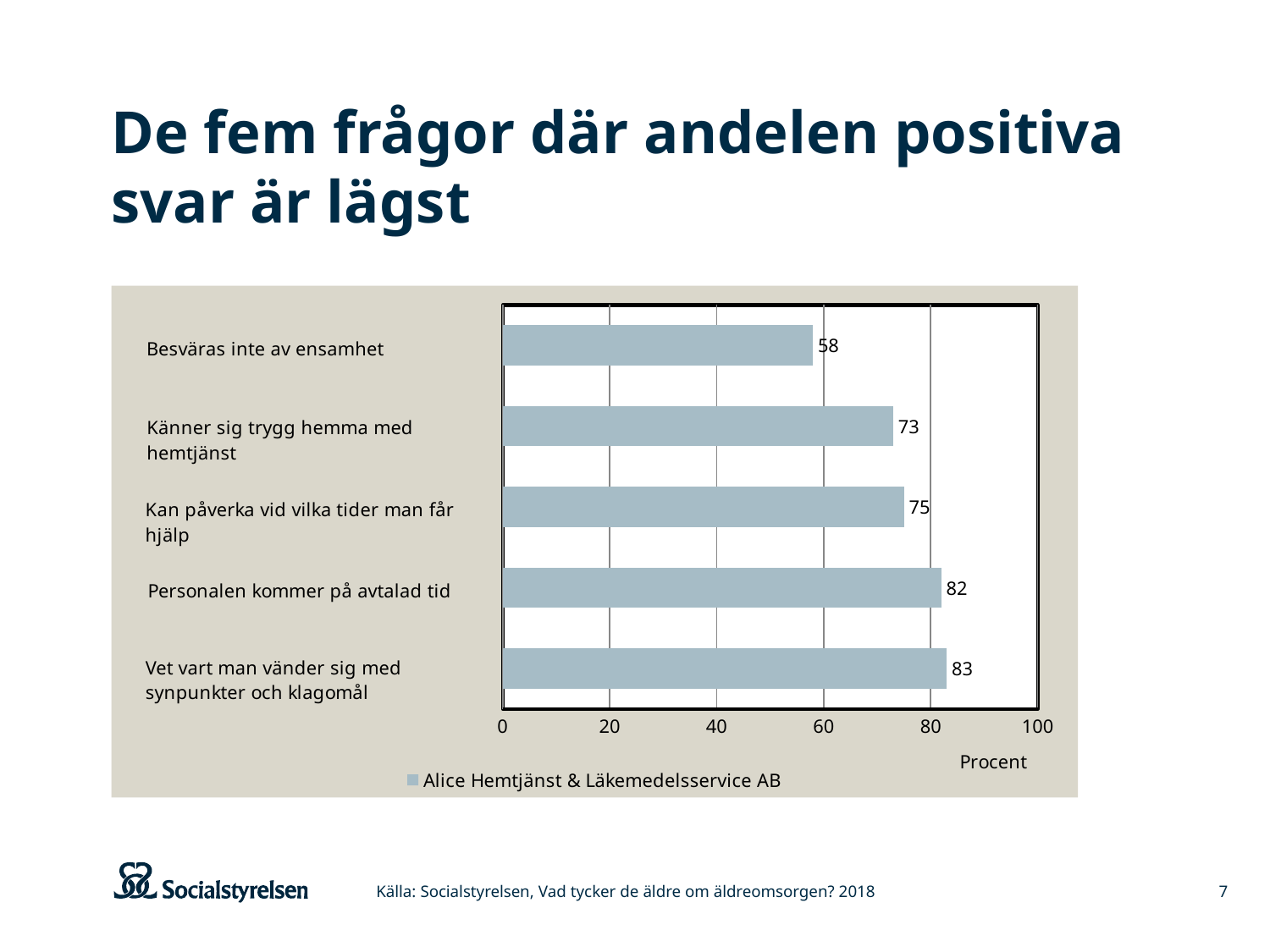
How many series does the legend list? 1 Which is larger: the value for "Kan påverka vid vilka tider man får hjälp" or the value for "Känner sig trygg hemma med hemtjänst"? Kan påverka vid vilka tider man får hjälp What is the difference between the values for "Vet vart man vänder sig med synpunkter och klagomål" and "Besväras inte av ensamhet"? 25 Which category has the lowest value? Besväras inte av ensamhet What is the value for "Känner sig trygg hemma med hemtjänst"? 73 Which category has the highest value? Vet vart man vänder sig med synpunkter och klagomål What kind of chart is shown on the slide? Bar chart How many categories are shown in the chart? 5 What is the value for "Besväras inte av ensamhet"? 58 What is the value for "Personalen kommer på avtalad tid"? 82 What series name is shown in the chart legend? Alice Hemtjänst & Läkemedelsservice AB Is the value for "Besväras inte av ensamhet" greater or less than 60? less